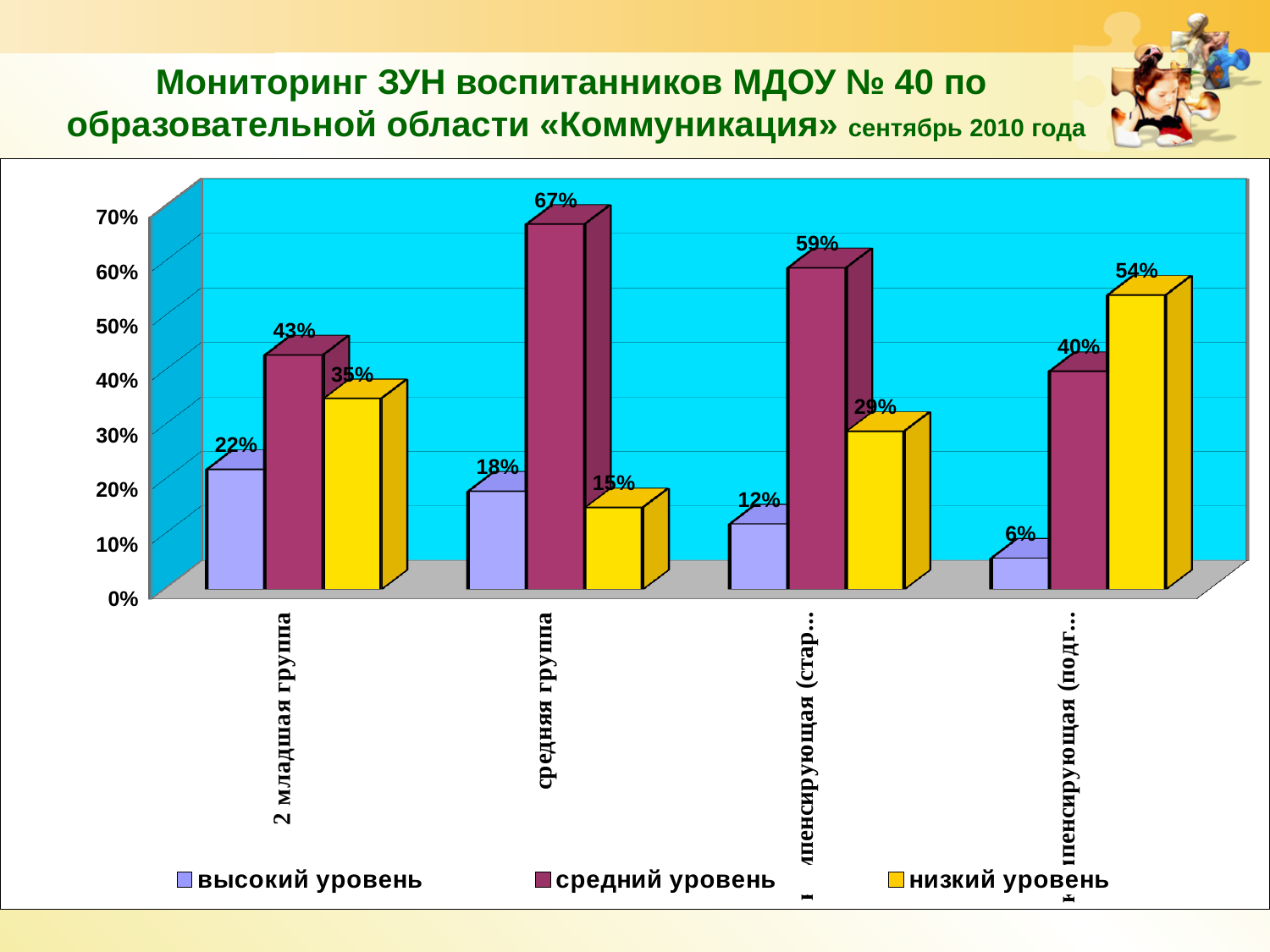
Which is larger for "средняя группа": "высокий уровень" or "низкий уровень"? высокий уровень How many series does the legend list? 3 Which category group has the lowest value for "высокий уровень"? the fourth (rightmost) group Does the value of "высокий уровень" rise or fall from left to right across the category groups? fall What is the value of "низкий уровень" for the fourth (rightmost) category group? 54% What type of chart is shown on the slide? bar chart What is the value of "высокий уровень" for "средняя группа"? 18% Which category group has the highest value for "средний уровень"? средняя группа What is the difference between "средний уровень" and "низкий уровень" for "2 младшая группа"? 8% What is the value of "средний уровень" for "2 младшая группа"? 43% What is the value of "низкий уровень" for "средняя группа"? 15% How many category groups are plotted along the x axis? 4